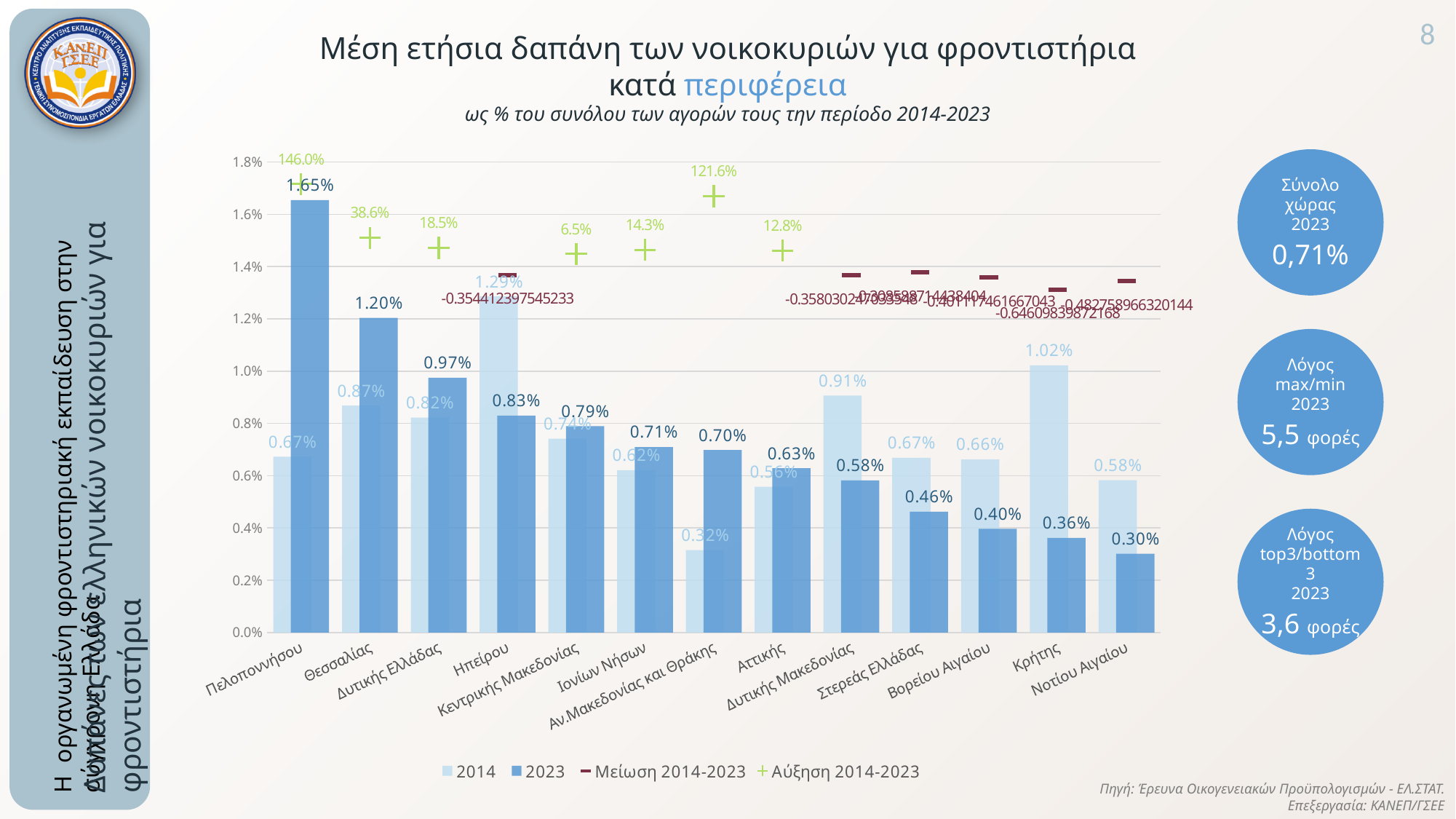
How many regions are shown on the x axis? 13 Which region has the lowest 2014 value? Αν.Μακεδονίας και Θράκης Which region has the highest 2023 value? Πελοποννήσου For Ηπείρου, which is larger: the 2014 value or the 2023 value? 2014 What is the 2023 value for Θεσσαλίας? 1.20% What is the Αύξηση 2014-2023 value shown for Αν.Μακεδονίας και Θράκης? 121.6% Do the 2023 values rise or fall from left to right along the x axis? Fall What kind of chart is this? Bar chart What is the 2014 value for Κρήτης? 1.02% What is the difference between the 2023 and 2014 values for Πελοποννήσου? 0.98 percentage points Which region has the lowest 2023 value? Νοτίου Αιγαίου How many series does the legend list? 4